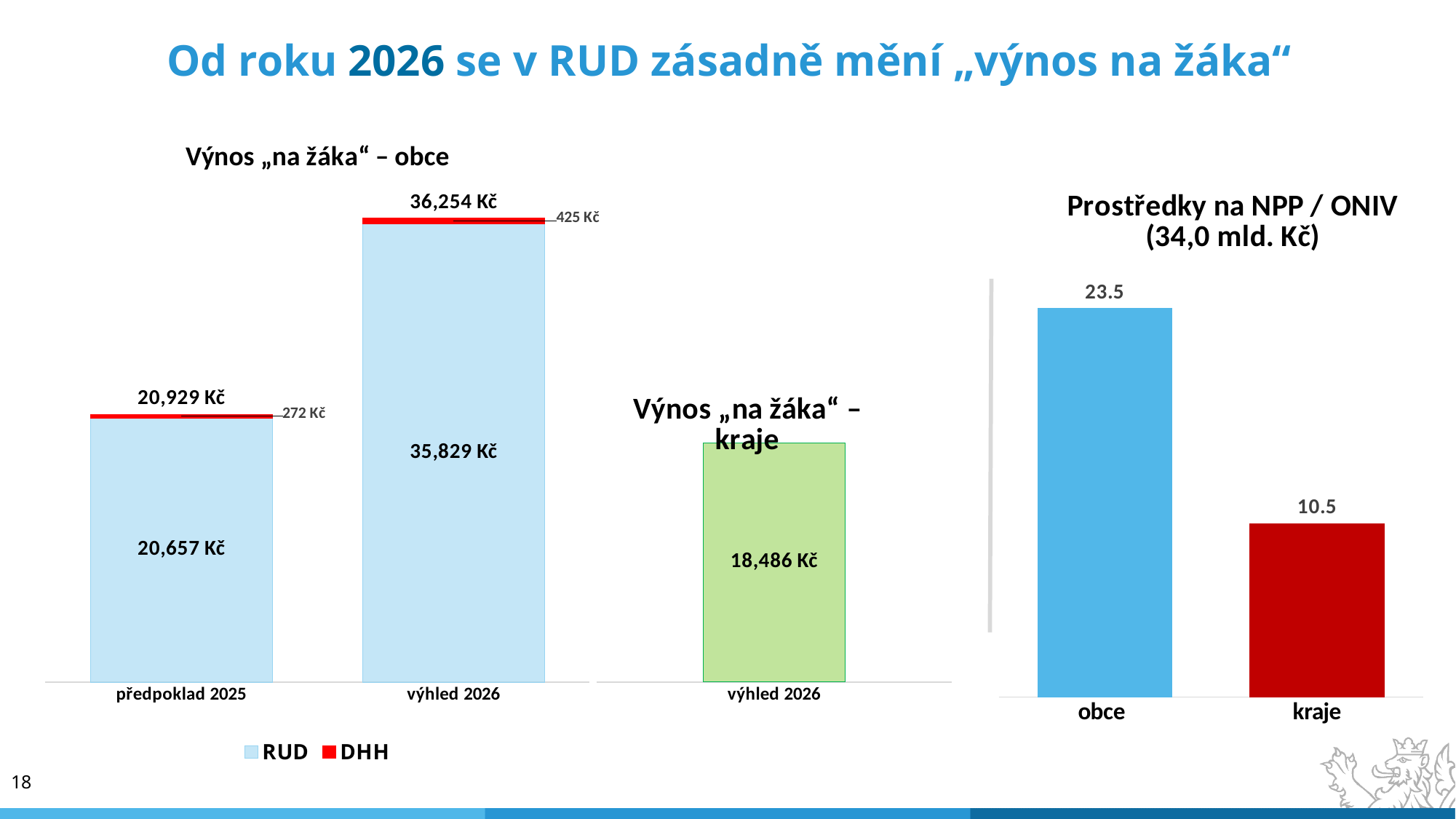
In the chart "Výnos „na žáka“ – obce", which series is shown in red? DHH In the chart "Prostředky na NPP / ONIV", which category has the lowest value? kraje In the chart "Výnos „na žáka“ – obce", what is the difference between the RUD values for výhled 2026 and předpoklad 2025? 15,172 Kč In the chart "Výnos „na žáka“ – obce", how many series does the legend list? 2 In the chart "Výnos „na žáka“ – obce", what is the RUD value for předpoklad 2025? 20,657 Kč What kind of chart is "Prostředky na NPP / ONIV"? bar chart In the chart "Prostředky na NPP / ONIV", what is the value for obce? 23.5 In the chart "Výnos „na žáka“ – obce", what is the total of the stacked bar for výhled 2026? 36,254 Kč In the chart "Výnos „na žáka“ – obce", what is the total of the stacked bar for předpoklad 2025? 20,929 Kč In the chart "Prostředky na NPP / ONIV", what is the difference between the values for obce and kraje? 13.0 In the chart "Výnos „na žáka“ – obce", what is the DHH value for výhled 2026? 425 Kč In the chart "Výnos „na žáka“ – kraje", what is the value for výhled 2026? 18,486 Kč